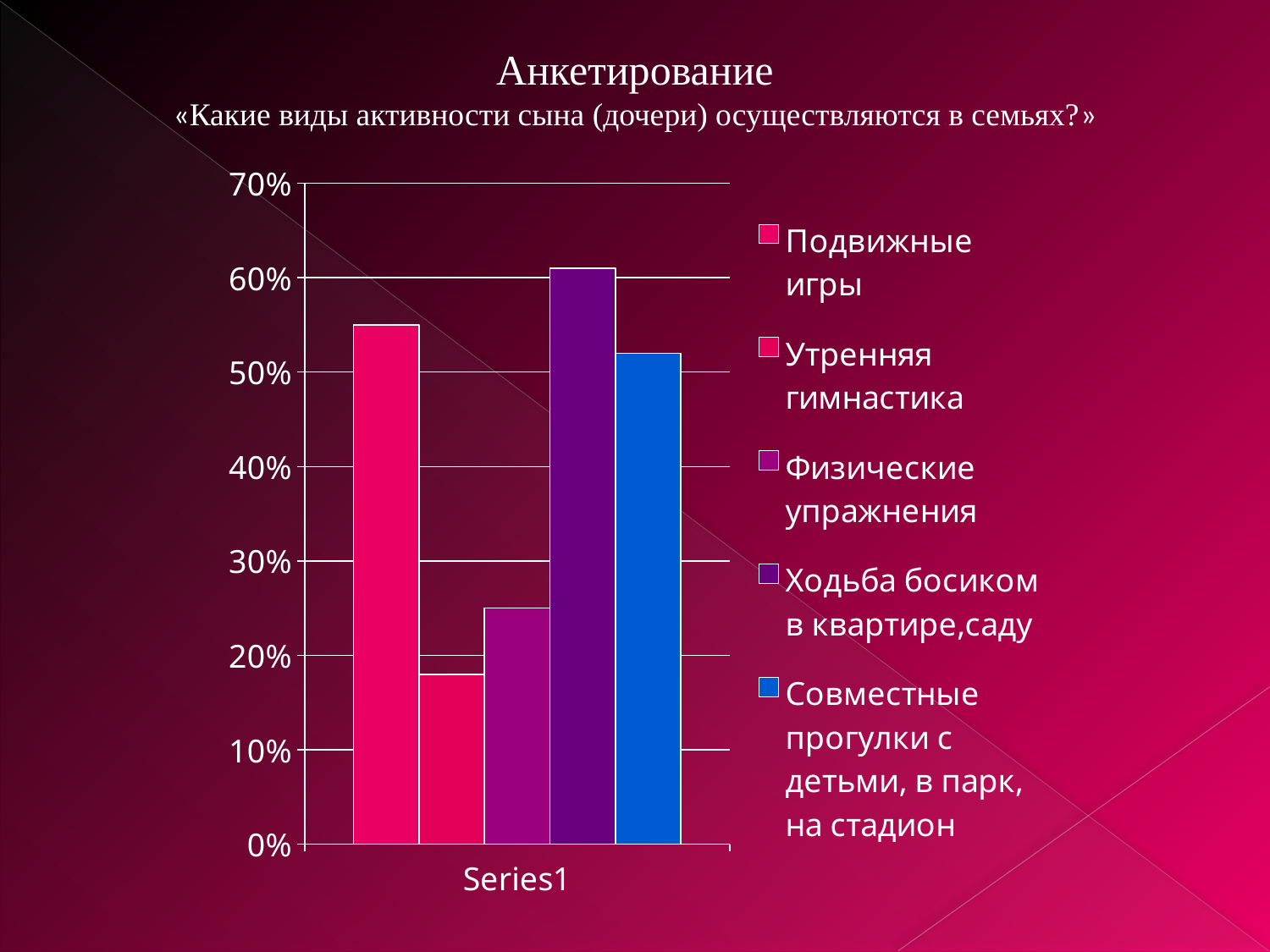
Which activity has the highest bar? Ходьба босиком в квартире,саду Is the value for Совместные прогулки с детьми, в парк, на стадион greater or less than 60%? less Which activity has the lowest bar? Утренняя гимнастика What kind of chart is shown on the slide? bar chart Is the value for Физические упражнения greater or less than 30%? less Which is larger, the value for Подвижные игры or the value for Физические упражнения? Подвижные игры How many entries does the legend list? 5 What colour is the bar for Совместные прогулки с детьми, в парк, на стадион? blue Is the value for Подвижные игры greater or less than 50%? greater What label is shown on the horizontal axis below the bars? Series1 How many bars are plotted in the chart? 5